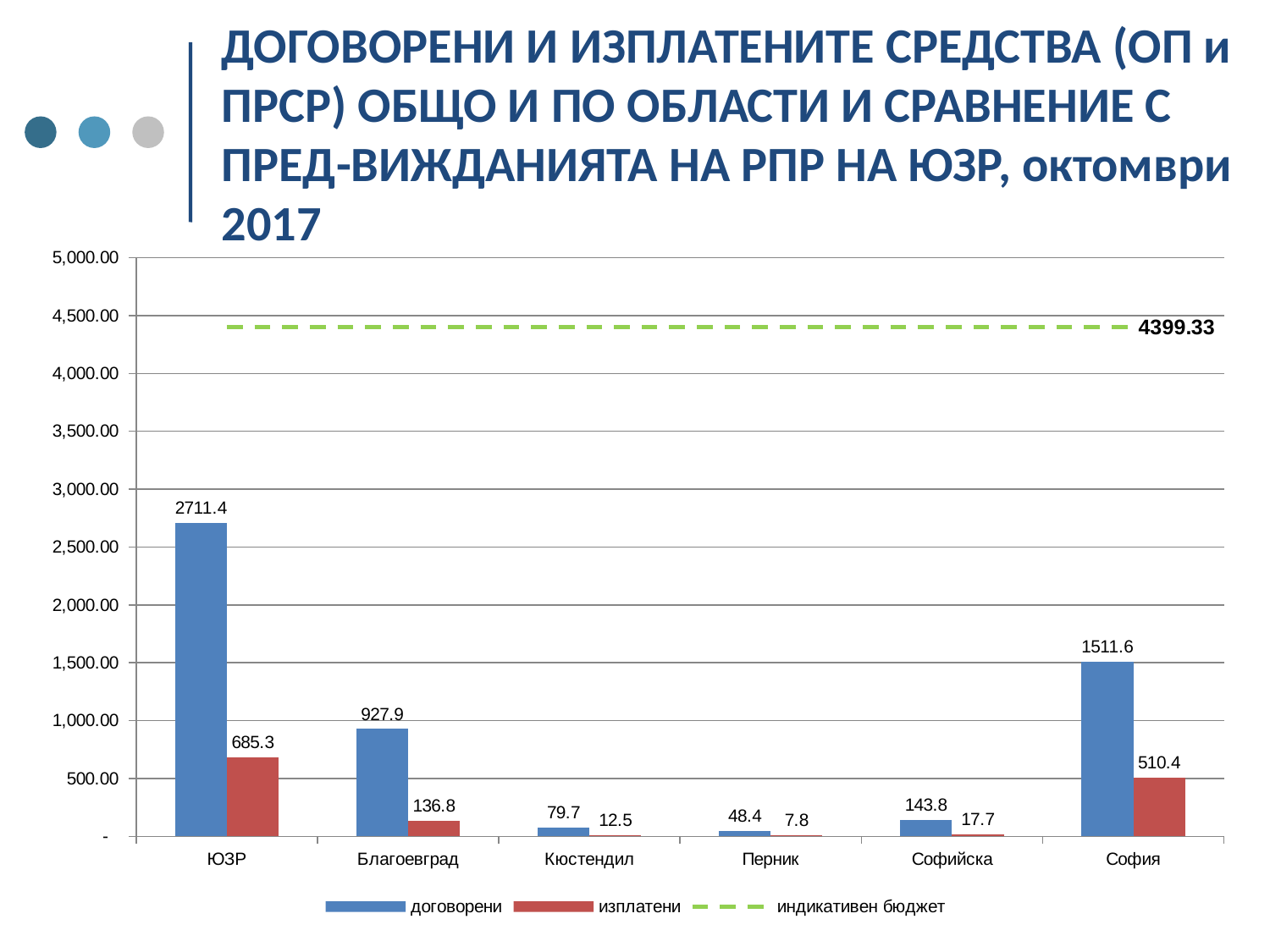
How many categories are shown on the x axis? 6 What colour are the изплатени bars? red What is the value of изплатени for Перник? 7.8 What is the value of изплатени for София? 510.4 Which is larger, договорени for София or договорени for Благоевград? договорени for София Which category has the lowest изплатени value? Перник What kind of chart is shown on the slide? bar chart Which category has the highest договорени value? ЮЗР What value is labelled on the dashed индикативен бюджет line? 4399.33 What is the value of договорени for ЮЗР? 2711.4 What is the difference between договорени and изплатени for Благоевград? 791.1 How many series does the legend list? 3